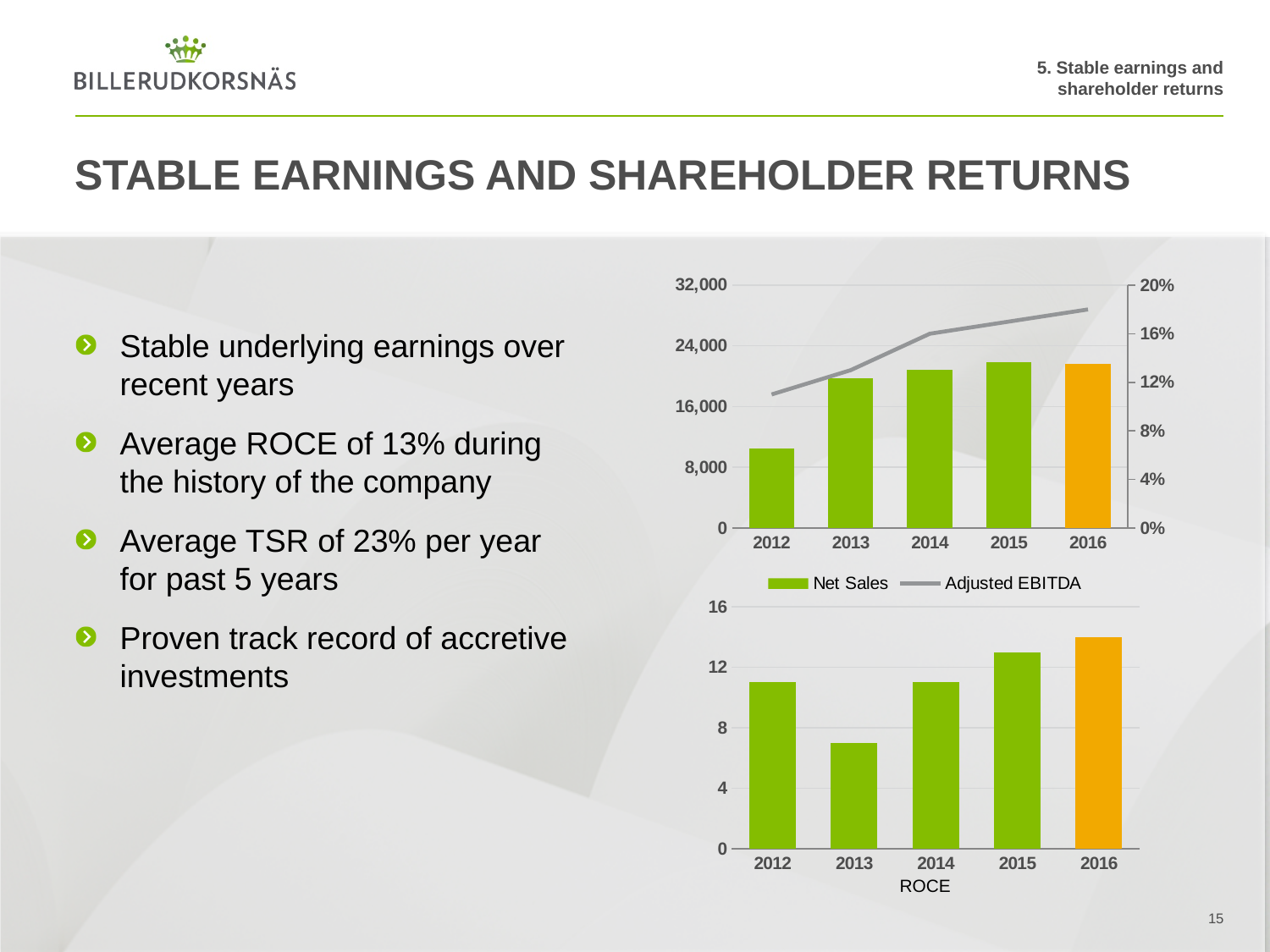
In the bottom ROCE chart, which year has the highest value? 2016 In the bottom ROCE chart, which year has the lowest value? 2013 In the top chart, does the Adjusted EBITDA line rise or fall from 2012 to 2016? rise In the top chart, which year has the lowest Net Sales? 2012 In the top chart, is the Net Sales value for 2015 greater or less than 16,000? greater How many years are shown on the x axis of the bottom ROCE chart? 5 How many series does the legend of the top chart list? 2 In the top chart, which series is shown as a line? Adjusted EBITDA In the top chart, is the Adjusted EBITDA value for 2016 greater or less than 16%? greater In the top chart, is the Net Sales value for 2012 greater or less than 16,000? less